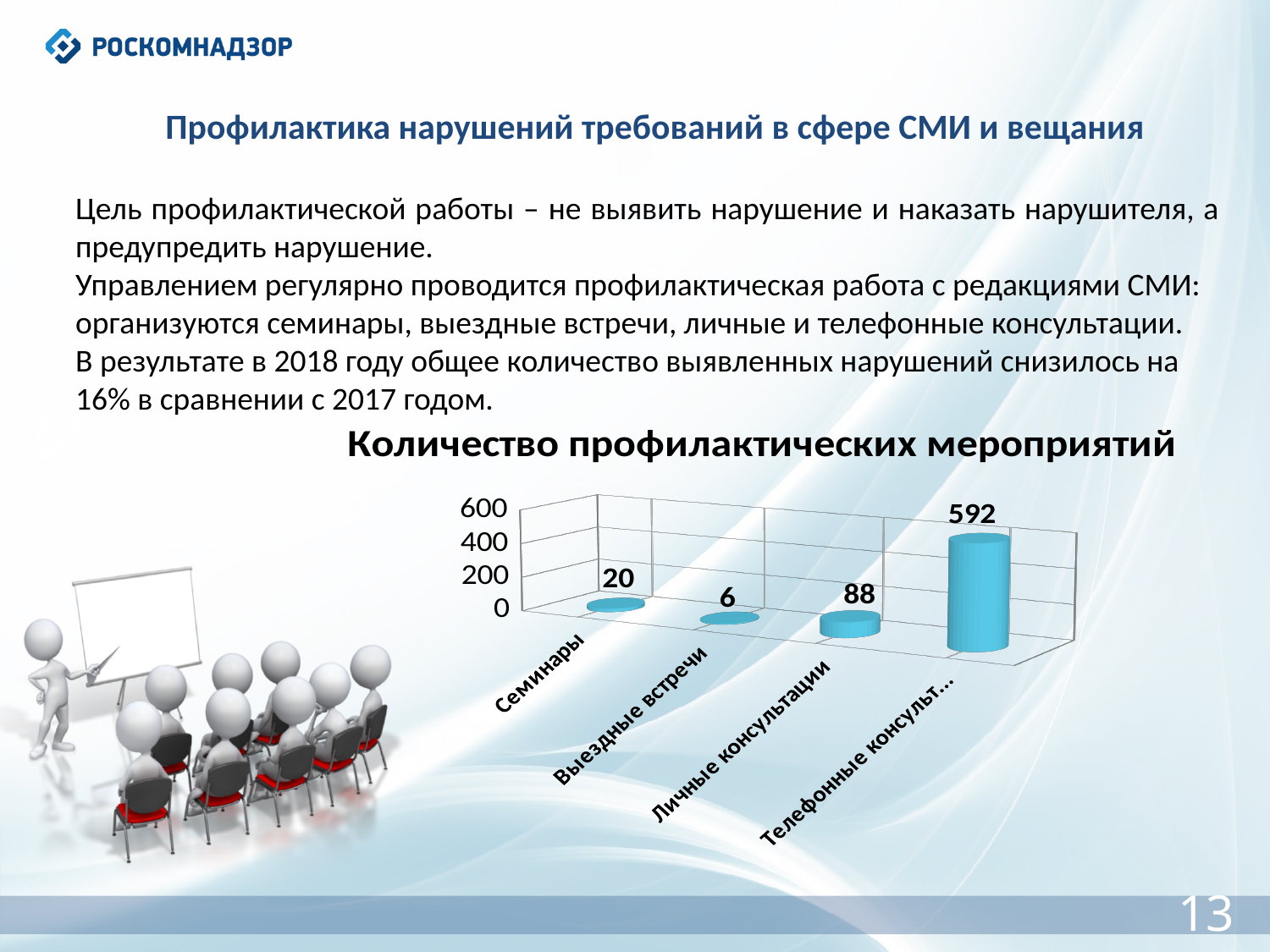
Is the value for the rightmost category (Телефонные консульт...) greater or less than 400? greater What kind of chart is shown on the slide? Bar chart Which category has the lowest value in the chart? Выездные встречи What is the value for Выездные встречи in the chart? 6 What is the difference between the values for Личные консультации and Семинары? 68 What is the title of the chart? Количество профилактических мероприятий What is the value for the rightmost category (Телефонные консульт...) in the chart? 592 What is the value for Семинары in the chart? 20 How many categories are shown in the chart? 4 Which category has the highest value in the chart? Телефонные консульт... What is the value for Личные консультации in the chart? 88 Which is larger, the value for Семинары or the value for Выездные встречи? Семинары